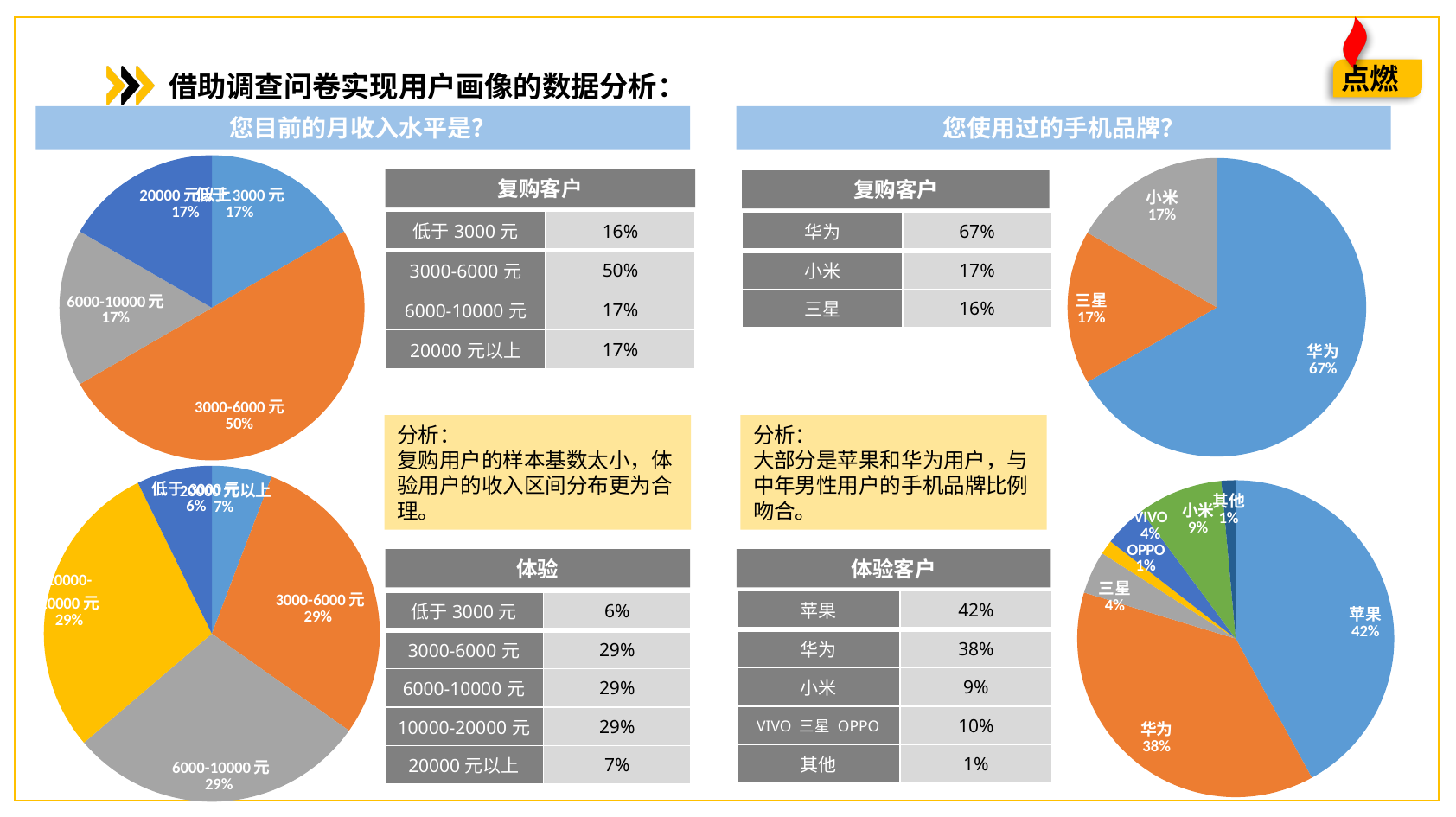
How many pie charts are shown on the slide? 4 In the top-left pie chart (monthly income of repeat customers), what share does the 3000-6000 元 slice have? 50% In the bottom-left pie chart (monthly income of experience customers), what share does the 低于 3000 元 slice have? 6% In the top-left pie chart (monthly income of repeat customers), which income bracket has the largest slice? 3000-6000 元 In the top-right pie chart (phone brands of repeat customers), which brand has the largest slice? 华为 How many slices does the bottom-left pie chart (monthly income of experience customers) have? 5 In the top-right pie chart (phone brands of repeat customers), what share does 华为 have? 67% In the bottom-right pie chart (phone brands of experience customers), which is larger, the 小米 slice or the 三星 slice? 小米 In the bottom-right pie chart (phone brands of experience customers), what is the difference between the 苹果 share and the 华为 share? 4% What kind of chart is used in the top-left of the slide for monthly income of repeat customers? pie chart